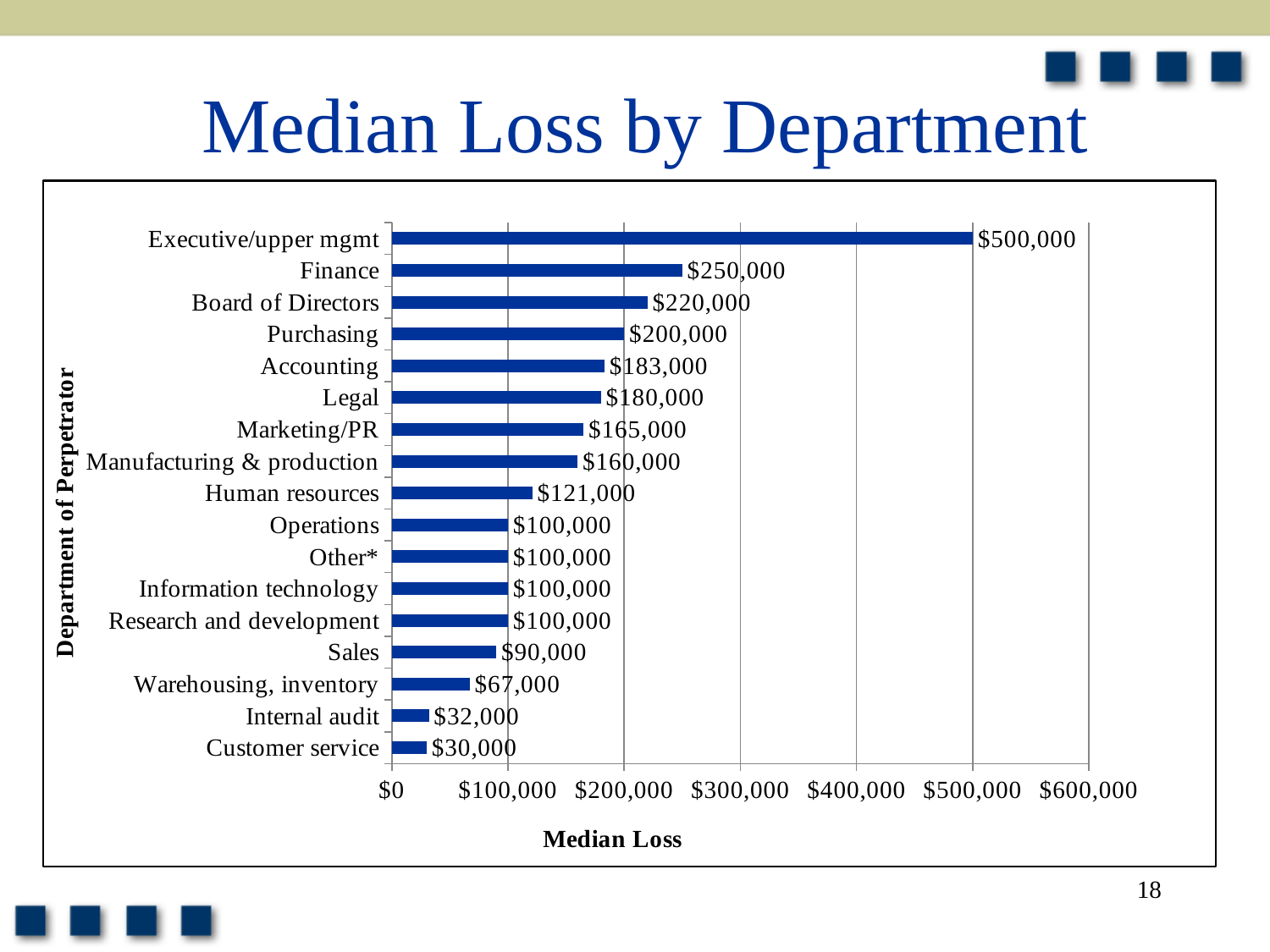
What is the label of the x axis? Median Loss How many departments are shown in the chart? 17 Which has a larger median loss, Board of Directors or Purchasing? Board of Directors Which has a larger median loss, Sales or Marketing/PR? Marketing/PR What is the median loss for Warehousing, inventory? $67,000 What kind of chart is shown on the slide? Bar chart What is the median loss for Human resources? $121,000 What is the median loss for Finance? $250,000 What is the difference between the median loss for Accounting and Legal? $3,000 Which department has the highest median loss? Executive/upper mgmt Which department has the lowest median loss? Customer service What is the difference between the median loss for Executive/upper mgmt and Finance? $250,000